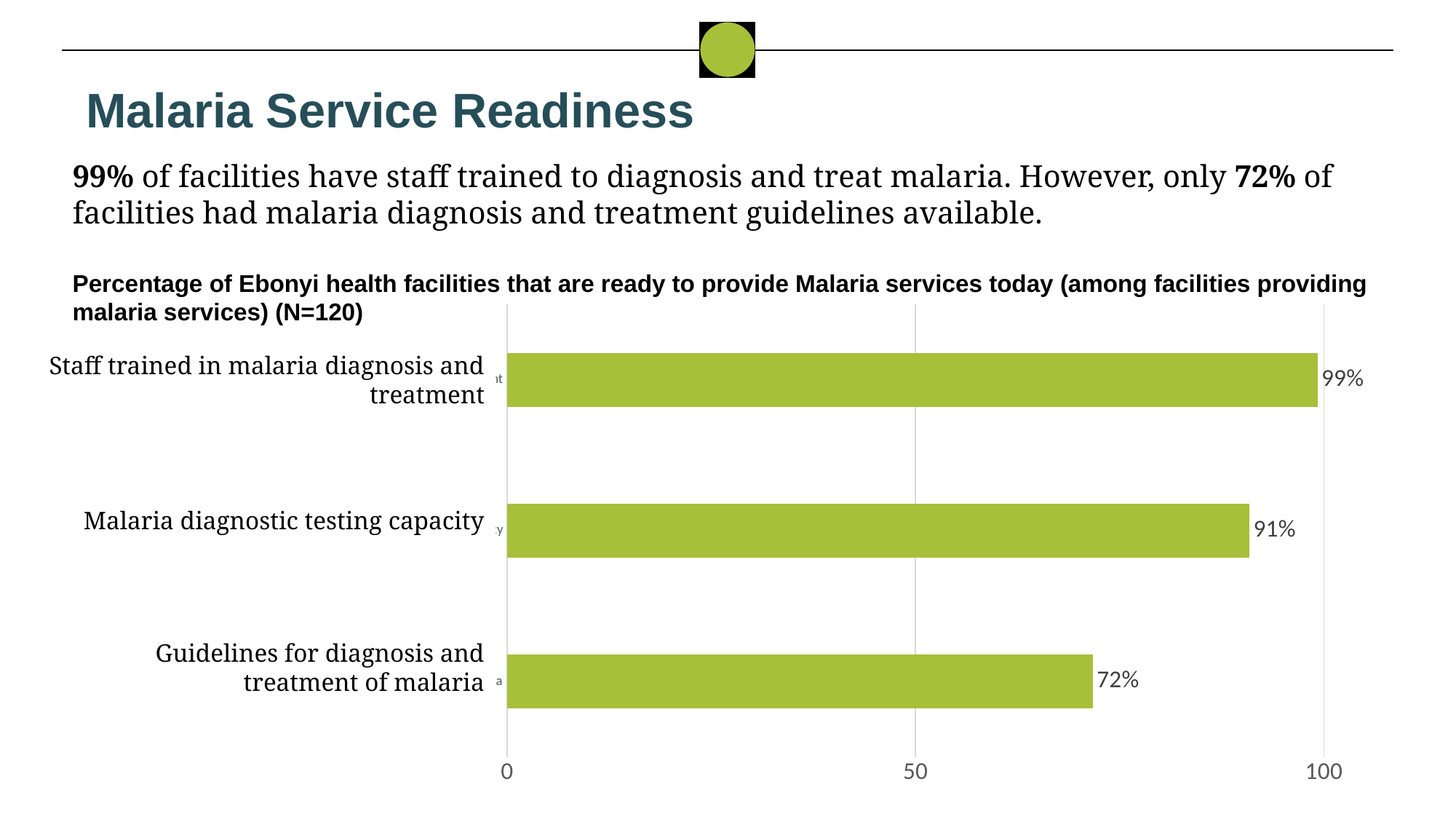
What is the value for Malaria diagnostic testing capacity? 91% Is the value for Guidelines for diagnosis and treatment of malaria greater or less than 50? greater What is the sample size (N) stated in the chart title? 120 How many categories are shown in the chart? 3 Which category has the highest value? Staff trained in malaria diagnosis and treatment What is the difference between the values for Staff trained in malaria diagnosis and treatment and Guidelines for diagnosis and treatment of malaria? 27% What is the difference between Malaria diagnostic testing capacity and Guidelines for diagnosis and treatment of malaria? 19% What kind of chart is shown on the slide? Bar chart Which is larger: Malaria diagnostic testing capacity or Guidelines for diagnosis and treatment of malaria? Malaria diagnostic testing capacity Which category has the lowest value? Guidelines for diagnosis and treatment of malaria What percentage of facilities have guidelines for diagnosis and treatment of malaria? 72% What percentage of facilities have staff trained in malaria diagnosis and treatment? 99%